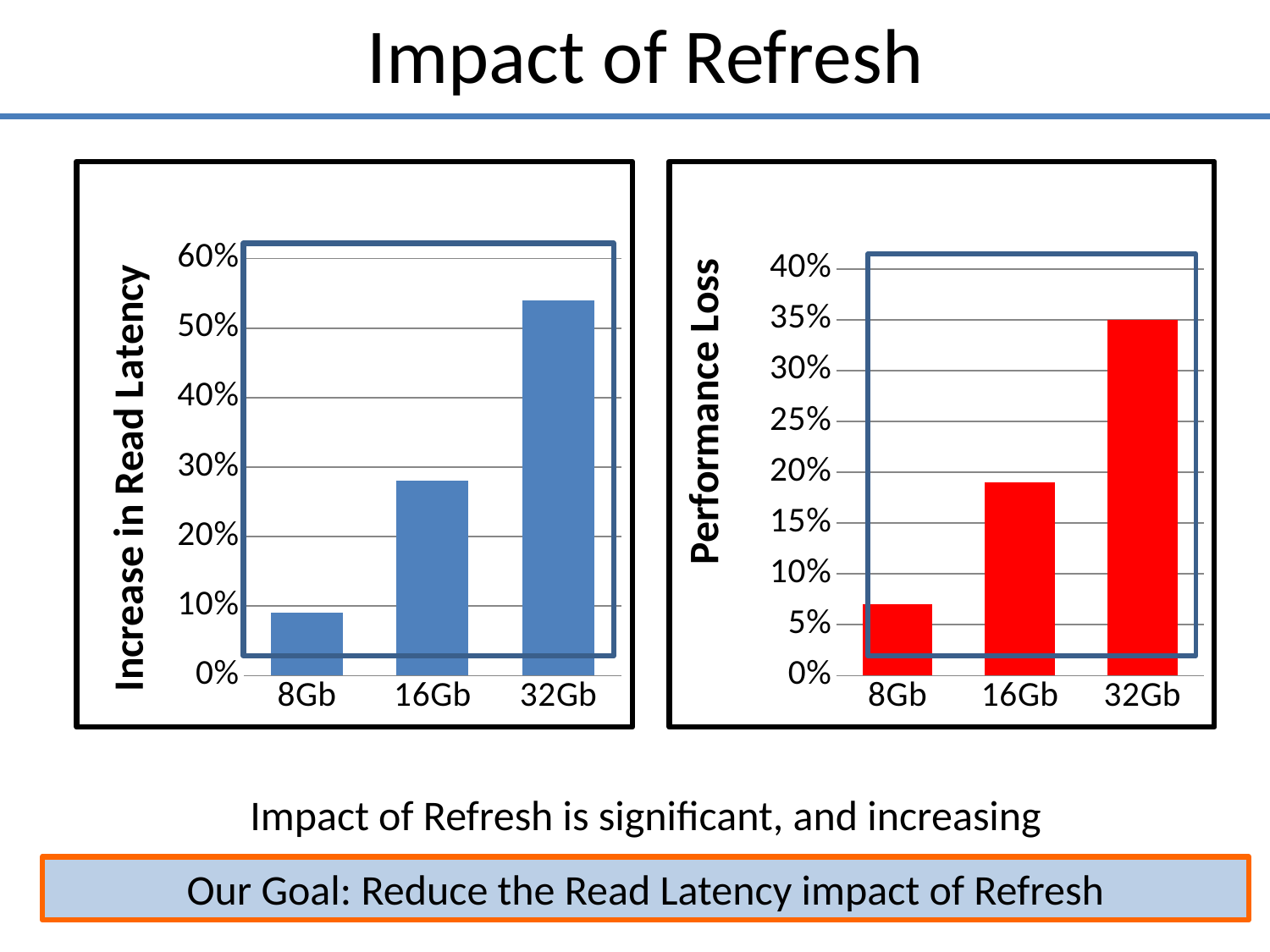
In the left chart (Increase in Read Latency), is the value for 32Gb greater or less than 50%? greater What is the y-axis title of the right chart? Performance Loss In the right chart (Performance Loss), which category has the lowest value? 8Gb What colour are the bars in the right chart (Performance Loss)? red In the right chart (Performance Loss), is the value for 8Gb greater or less than 10%? less What kind of chart is the left chart (Increase in Read Latency)? bar chart In the left chart (Increase in Read Latency), which is larger, the value for 16Gb or the value for 32Gb? 32Gb In the left chart (Increase in Read Latency), which category has the highest value? 32Gb How many categories are shown on the x axis of the right chart (Performance Loss)? 3 In the right chart (Performance Loss), is the value for 16Gb greater or less than 15%? greater In the right chart (Performance Loss), do the values rise or fall from 8Gb to 32Gb? rise